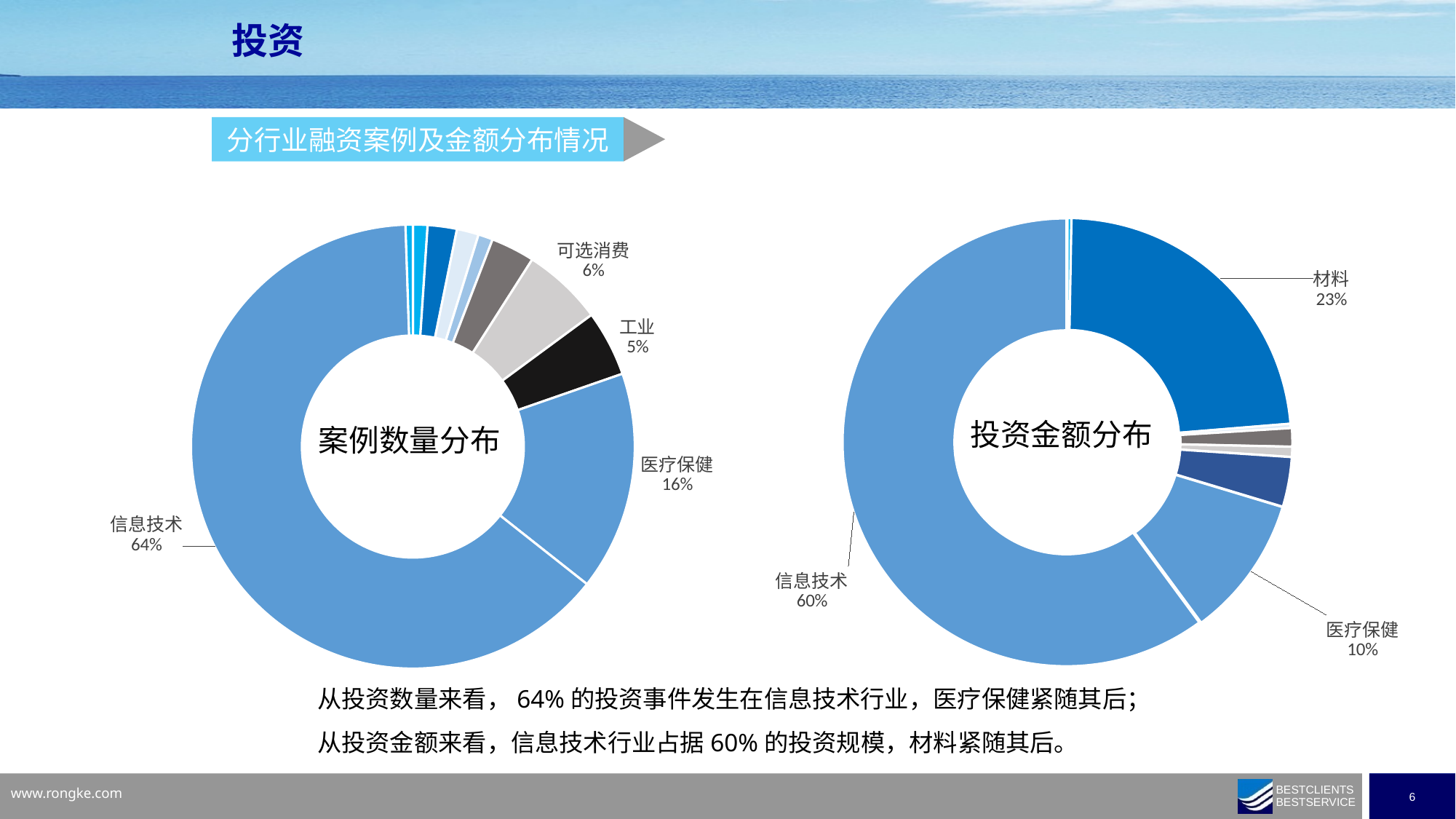
In the 投资金额分布 chart, what share does 材料 have? 23% In the 案例数量分布 chart, what share does 工业 have? 5% In the 案例数量分布 chart, which is larger, the share of 可选消费 or the share of 工业? 可选消费 In the 案例数量分布 chart, what share does 医疗保健 have? 16% In the 案例数量分布 chart, what is the difference between the shares of 信息技术 and 医疗保健? 48% In the 案例数量分布 chart, what share does 信息技术 have? 64% In the 投资金额分布 chart, which category has the largest share? 信息技术 What type of chart is the 投资金额分布 chart? Pie (doughnut) chart In the 投资金额分布 chart, what share does 医疗保健 have? 10% In the 案例数量分布 chart, what share does 可选消费 have? 6% In the 案例数量分布 chart, which category has the largest share? 信息技术 In the 投资金额分布 chart, what is the difference between the shares of 材料 and 医疗保健? 13%